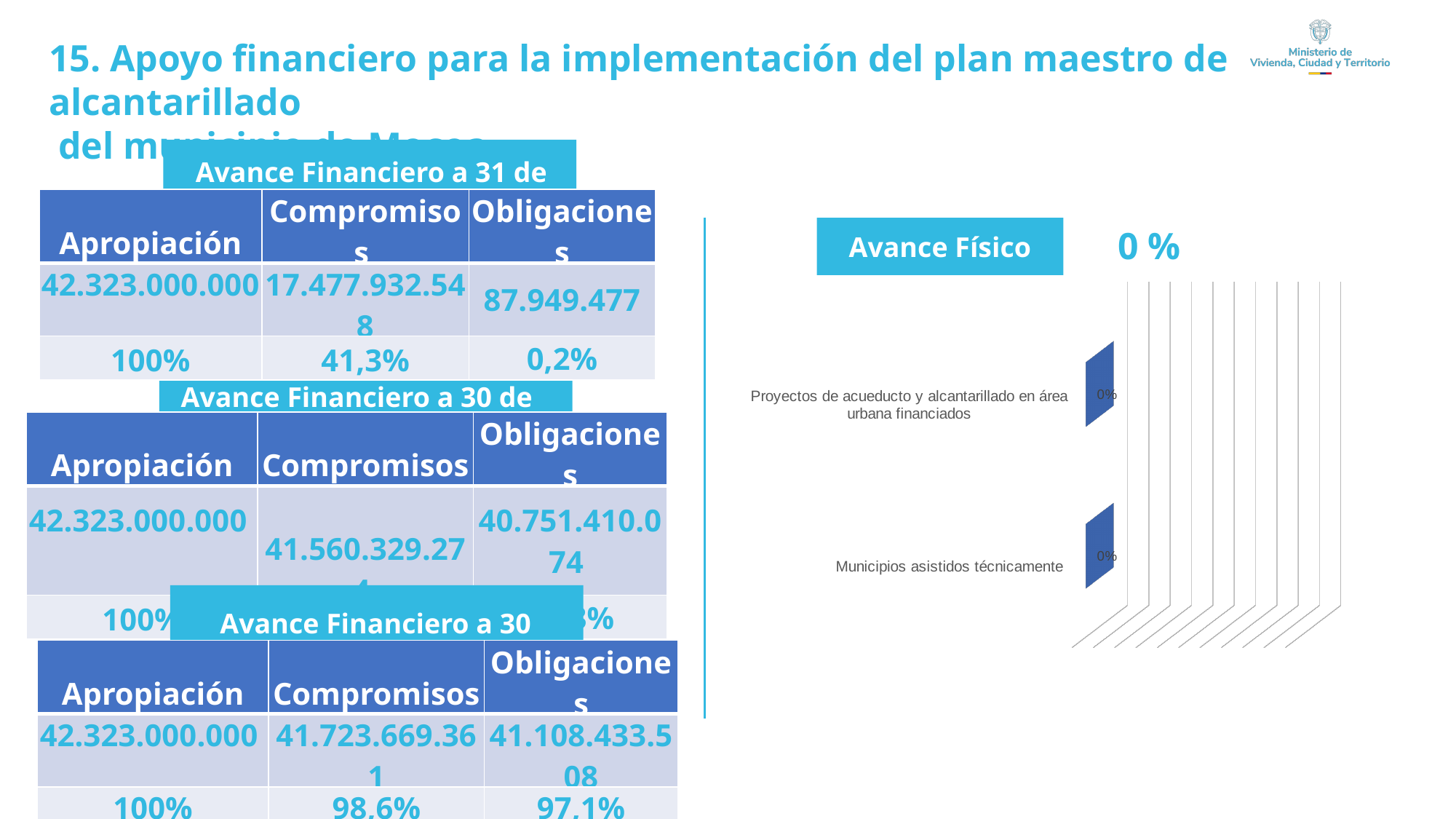
In the bar chart on the right, what is the value for 'Proyectos de acueducto y alcantarillado en área urbana financiados'? 0% What overall percentage is printed next to the 'Avance Físico' heading above the bar chart? 0 % What heading appears above the bar chart on the right? Avance Físico How many categories does the bar chart on the right show? 2 What kind of chart is shown on the right side of the slide? bar chart In the bar chart on the right, what is the value for 'Municipios asistidos técnicamente'? 0%